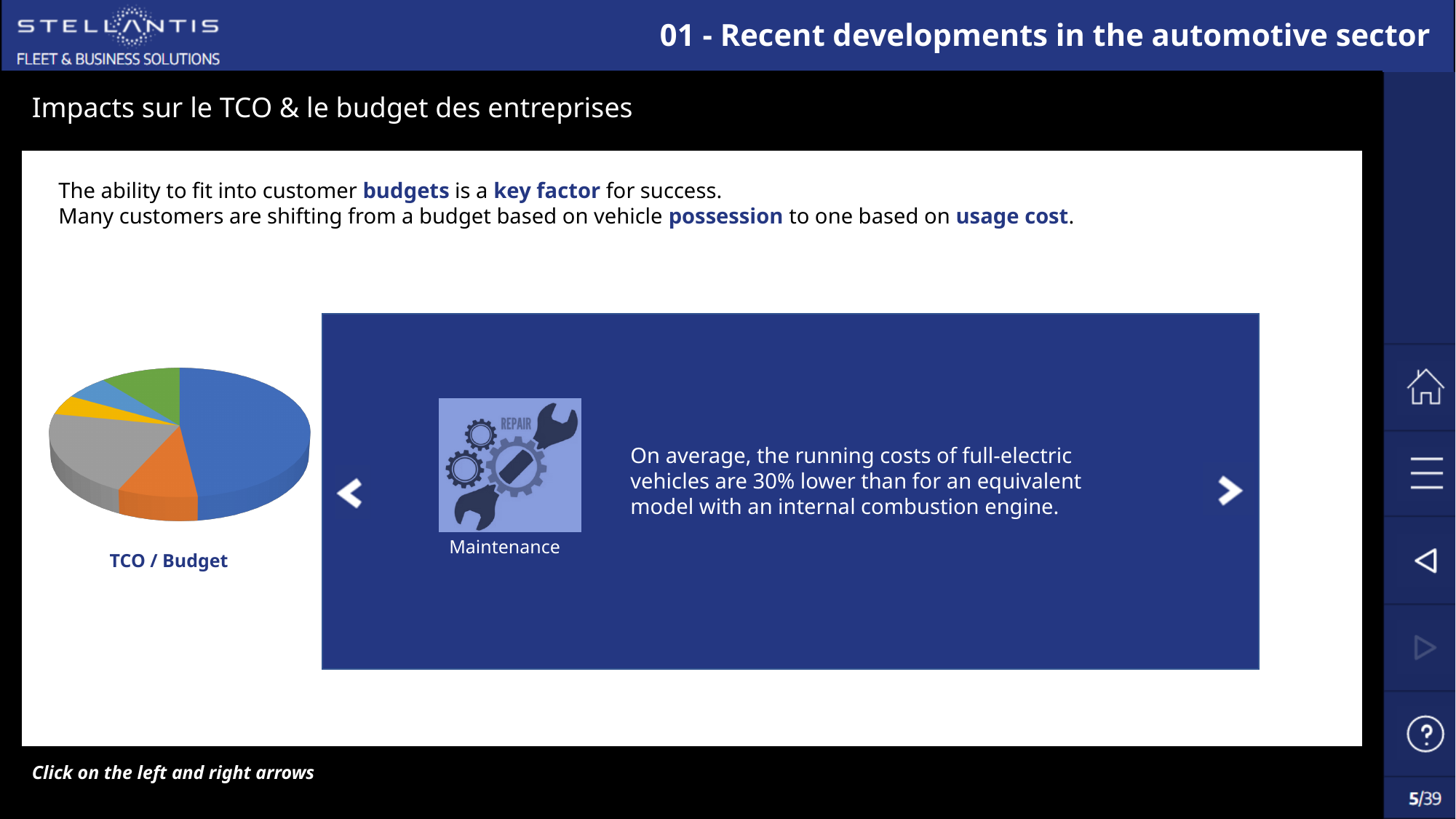
In the TCO / Budget pie chart, which is larger, the gray slice or the green slice? Gray Does the TCO / Budget pie chart display a legend or data labels? No Which colour slice is the smallest in the TCO / Budget pie chart? Yellow In the TCO / Budget pie chart, which is larger, the blue slice or the orange slice? Blue How many slices does the TCO / Budget pie chart have? 6 What is the title shown under the pie chart? TCO / Budget What kind of chart is shown on the slide? Pie chart Which colour slice is the largest in the TCO / Budget pie chart? Blue